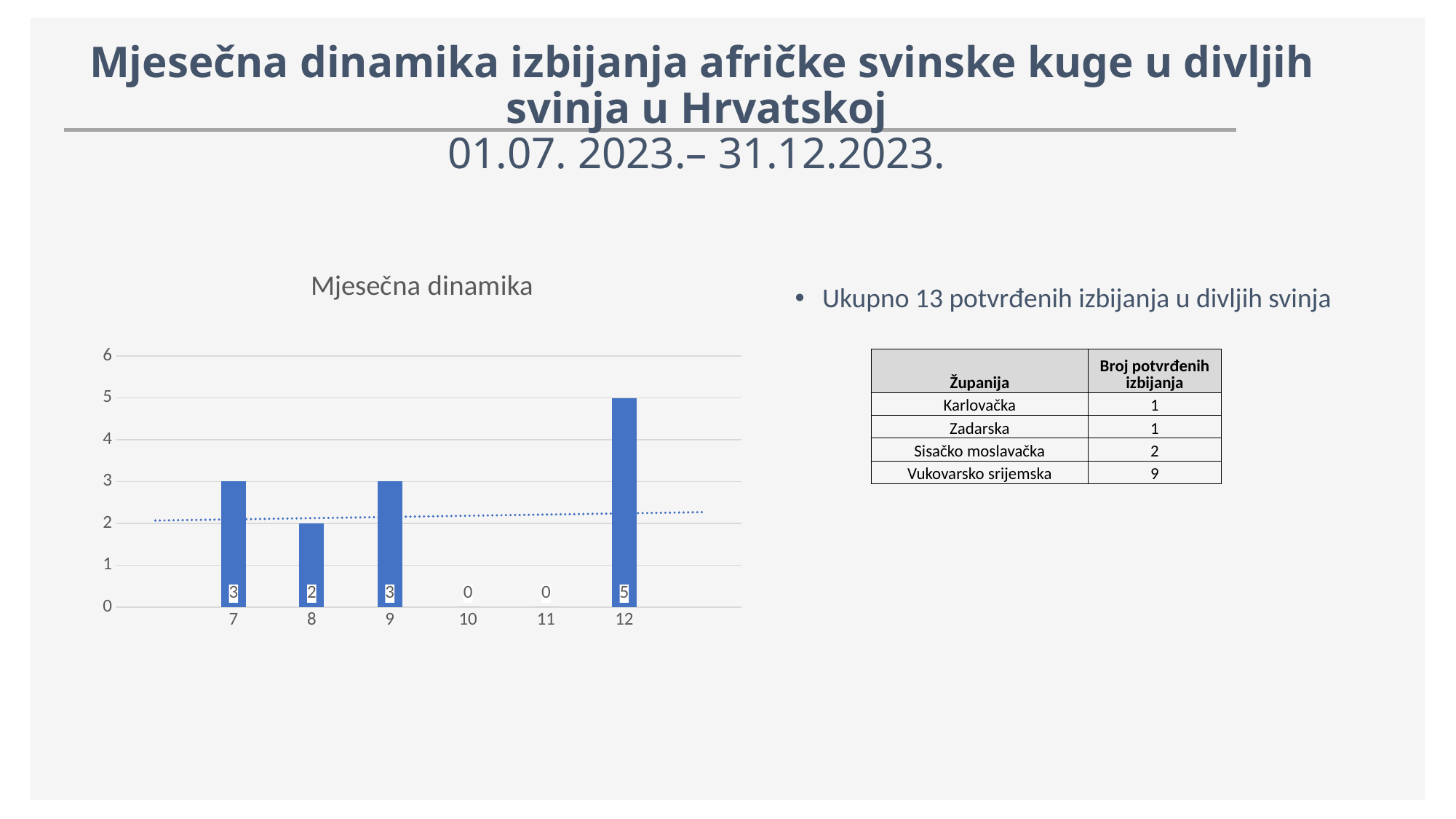
Which is larger, the value for month 7 or the value for month 8? 7 What is the title of the chart? Mjesečna dinamika What is the total of the values for months 7, 8 and 9? 8 What is the difference between the values for month 12 and month 9? 2 What is the value for month 12 in the chart? 5 What kind of chart is shown on the slide? bar chart How many months in the chart have a value of 0? 2 Which month has the highest value in the chart? 12 What is the value for month 8 in the chart? 2 What is the highest value shown on the y axis of the chart? 6 How many months are shown on the x axis of the chart? 6 What is the value for month 10 in the chart? 0